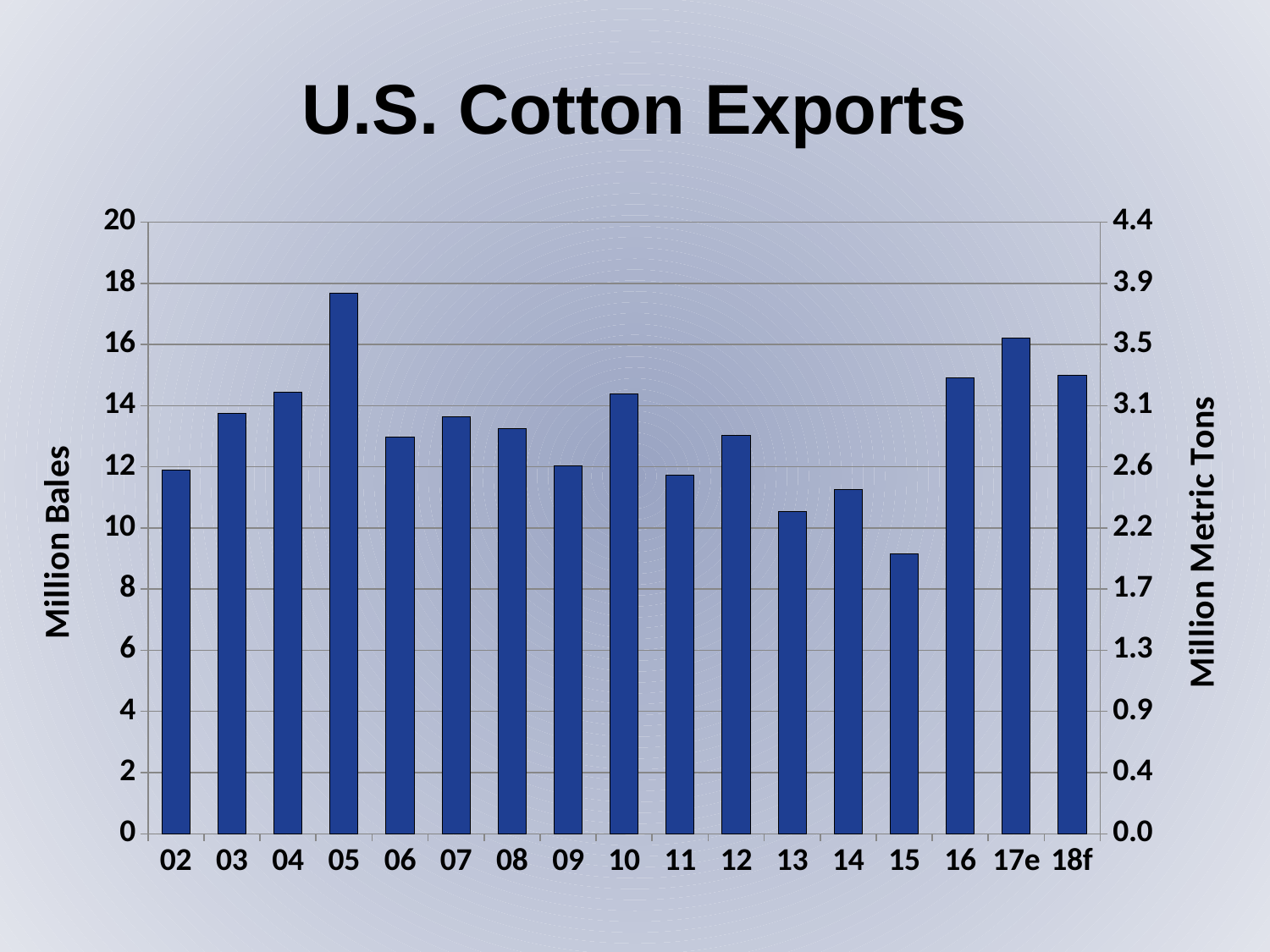
Which year has the highest cotton exports? 05 How many years (bars) are shown on the x axis? 17 What is the title of the chart? U.S. Cotton Exports Which year has the lowest cotton exports? 15 Is the value for 14 greater or less than 12 million bales? less Which is larger, the value for 13 or the value for 14? 14 Is the value for 05 greater or less than 16 million bales? greater Which is larger, the value for 17e or the value for 18f? 17e Is the value for 15 greater or less than 10 million bales? less What kind of chart is shown on the slide? bar chart What is the label of the left vertical axis? Million Bales